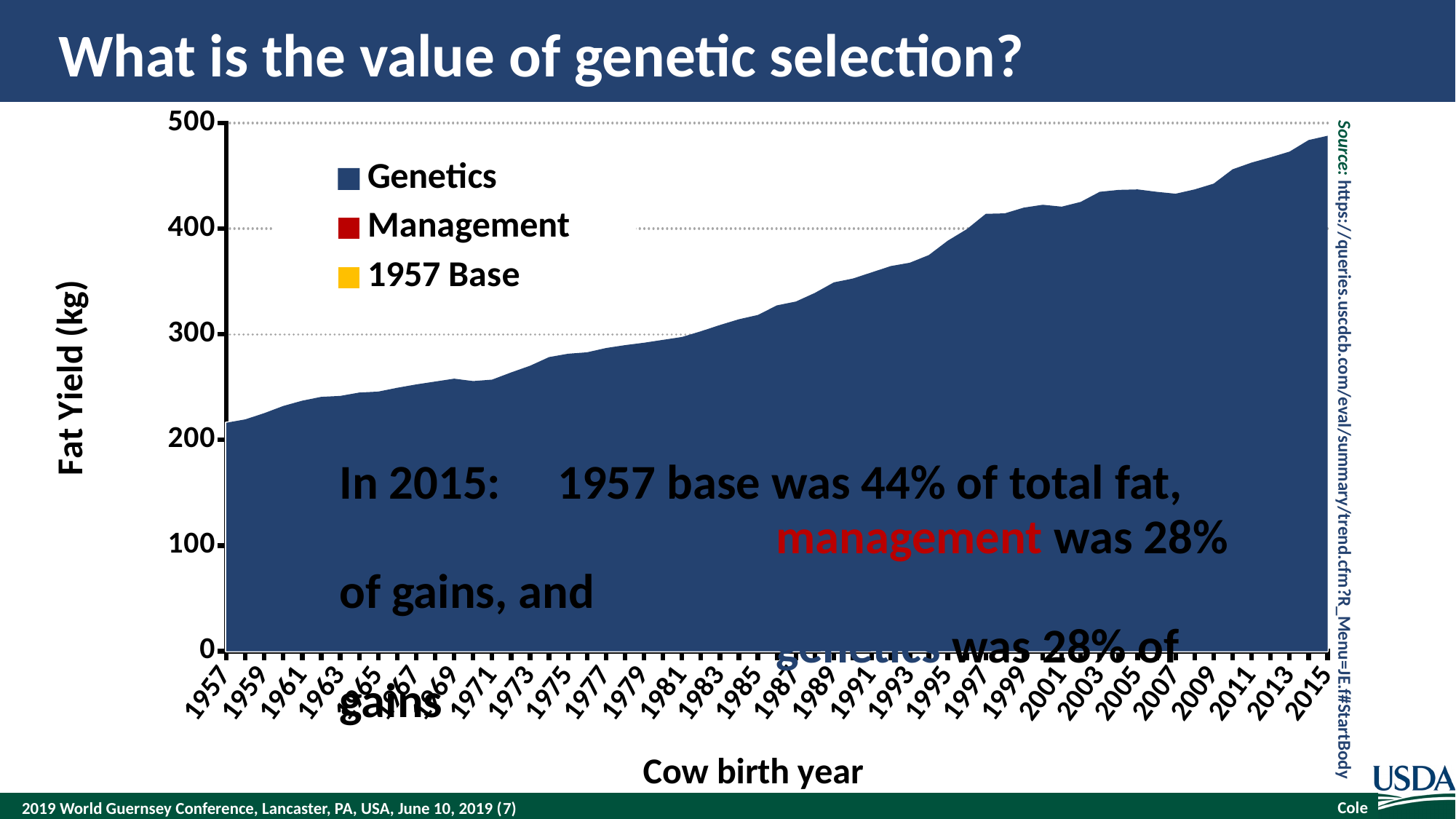
Which cow birth year has the highest fat yield? 2015 How many series does the legend list? 3 What is the label of the x axis? Cow birth year Which cow birth year has the lowest fat yield? 1957 What kind of chart is shown on the slide? area chart Is the fat yield for cow birth year 2015 greater or less than 400? greater What is the label of the y axis? Fat Yield (kg) Which has the larger fat yield, cow birth year 1957 or 2015? 2015 Is the fat yield for cow birth year 2009 greater or less than 400? greater Do the fat yield values rise or fall as cow birth year increases? rise Is the fat yield for cow birth year 1975 greater or less than 300? less